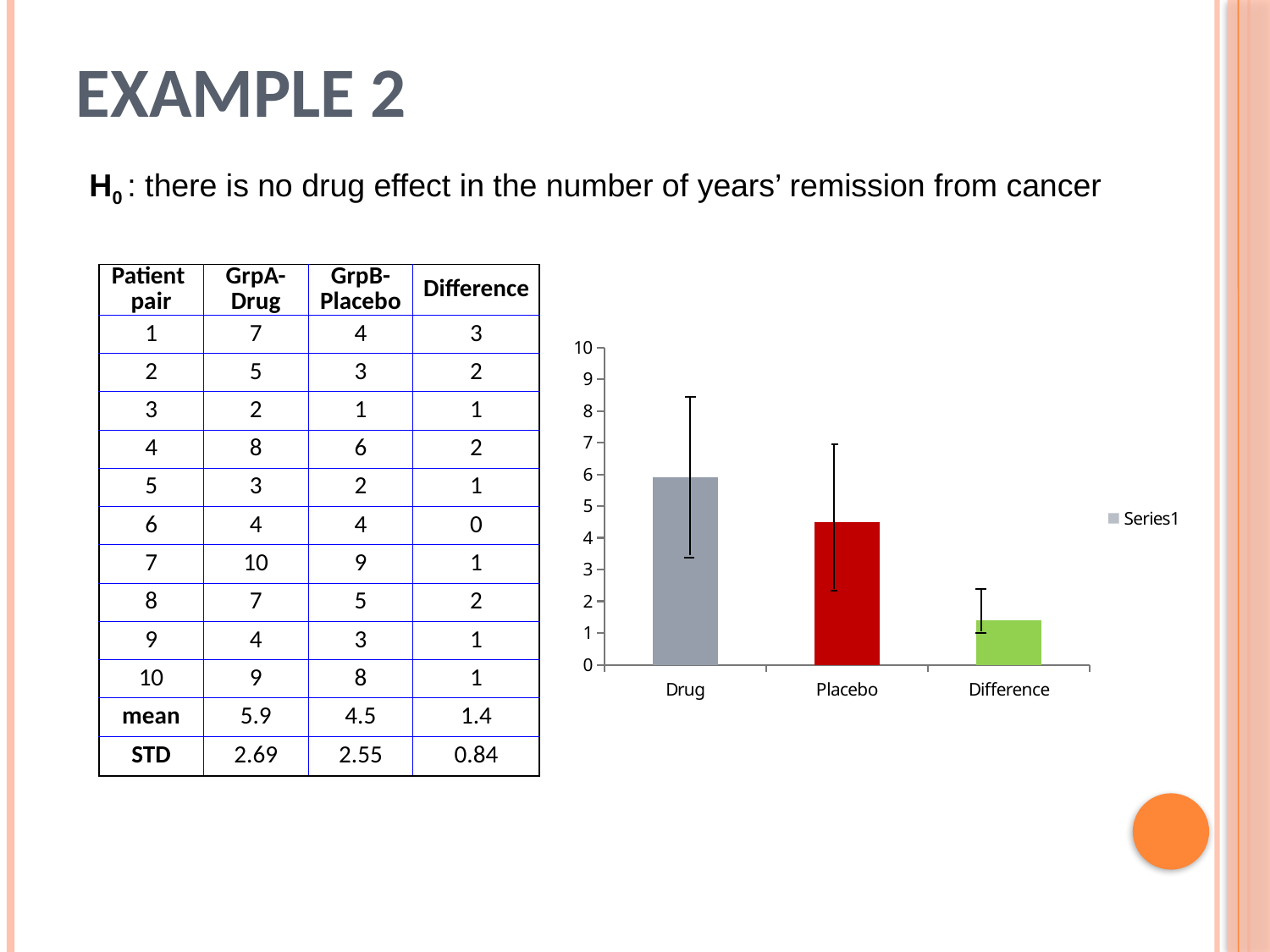
Which category has the shortest bar in the chart? Difference What kind of chart is shown on the slide? bar chart Do the bar heights rise or fall from left to right across the x axis? fall Which category has the tallest bar in the chart? Drug Is the bar for Difference greater or less than 2? less How many categories are shown on the x axis of the bar chart? 3 What is the name of the series shown in the chart legend? Series1 Is the bar for Placebo greater or less than 5? less Is the bar for Drug greater or less than 5? greater How many series does the chart legend list? 1 Which bar is taller, Drug or Placebo? Drug